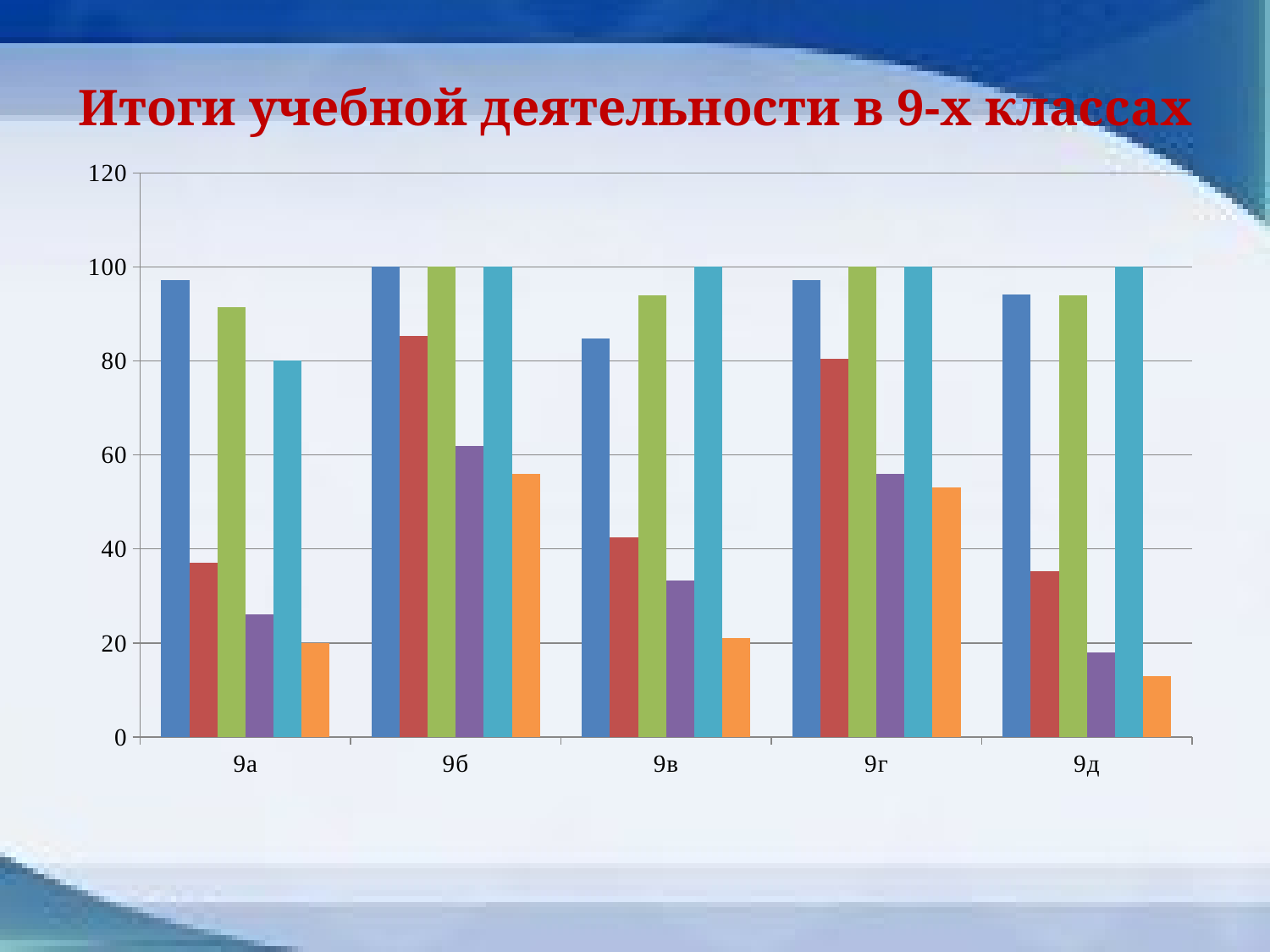
Which class has the lowest orange bar? 9д Is the value of the purple bar for 9в greater or less than 40? less What is the value of the light blue bar for 9б? 100 How many classes (categories) are shown on the x axis? 5 Is the value of the red bar for 9б greater or less than 80? greater Which class has the highest red bar? 9б Is the value of the orange bar for 9д greater or less than 20? less Which is larger, the purple bar for 9б or the purple bar for 9а? 9б What is the value of the orange bar for 9а? 20 What kind of chart is shown on the slide? bar chart What is the value of the light blue bar for 9а? 80 What is the title of the chart? Итоги учебной деятельности в 9-х классах